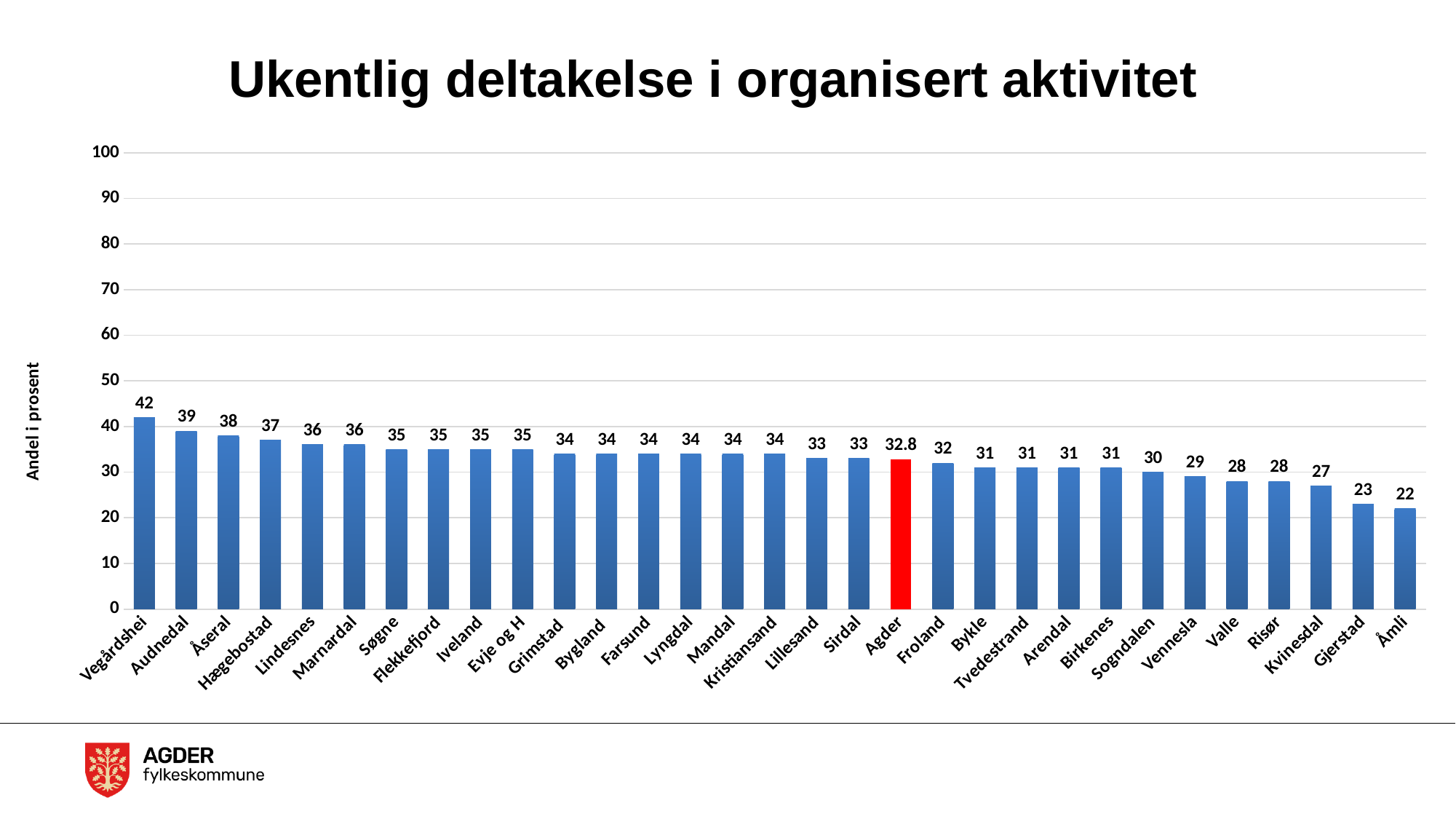
What is the difference between the values for Vegårdshei and Åmli? 20 Which is larger, the value for Audnedal or the value for Gjerstad? Audnedal What is the value for Arendal? 31 What kind of chart is shown on the slide? bar chart What is the value for Agder? 32.8 Which category has the lowest value? Åmli What is the value for Kristiansand? 34 Do the values rise or fall from left to right along the x axis? fall Which category has the highest value? Vegårdshei Is the value for Vegårdshei greater or less than 40? greater Which bar is coloured red? Agder How many categories are shown on the x axis? 31